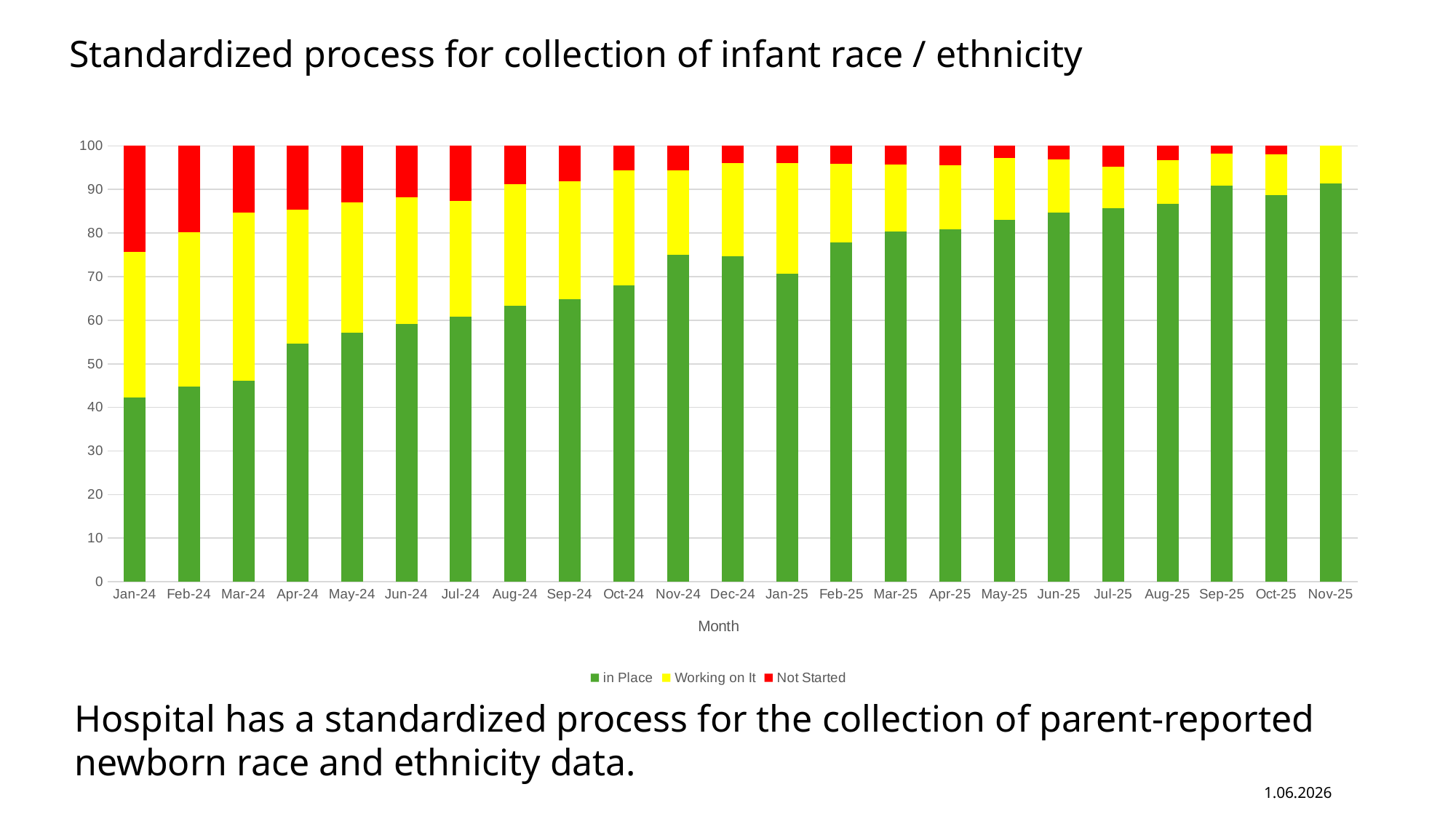
Which is larger, the 'in Place' value for Dec-24 or for Jan-25? Dec-24 Is the 'in Place' value for Jan-24 greater or less than 50? less How many series does the legend list? 3 How many months are shown on the x axis? 23 Is the 'in Place' value for Jul-25 greater or less than 80? greater What is the total height of each stacked bar, as read from the y axis? 100 Does the 'in Place' series generally rise or fall from Jan-24 to Nov-25? rise What is the title of the x axis? Month Which month has the largest 'Not Started' segment? Jan-24 Is the 'in Place' value for Nov-24 greater or less than 70? greater Which month has the lowest value for the 'in Place' series? Jan-24 What kind of chart is shown on the slide? stacked bar chart